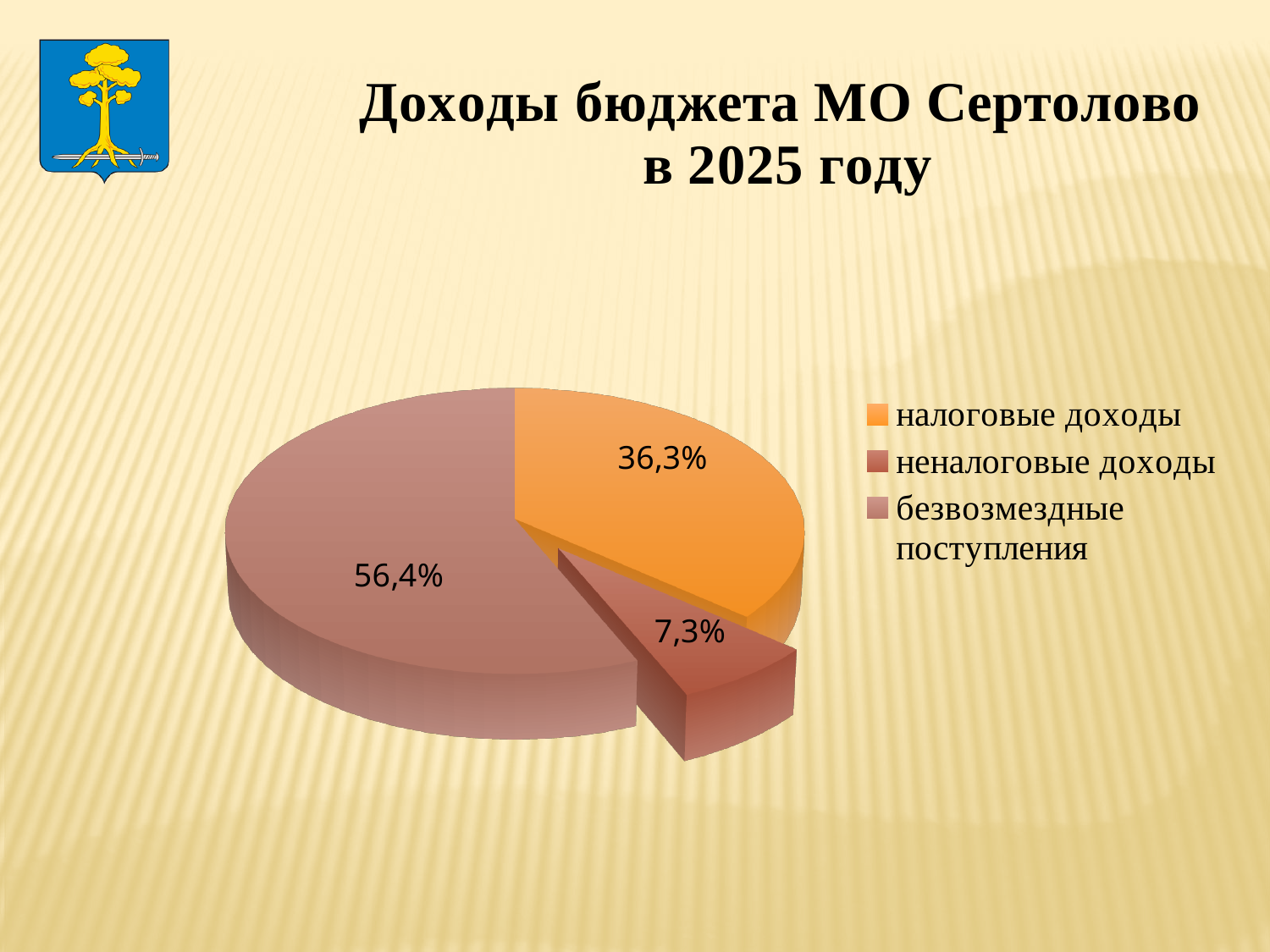
Which is larger: the share of налоговые доходы or the share of неналоговые доходы? налоговые доходы Which category has the smallest share of the pie? неналоговые доходы What is the difference between the shares of налоговые доходы and неналоговые доходы? 29,0% Which category has the largest share of the pie? безвозмездные поступления What share of the pie does безвозмездные поступления represent? 56,4% What is the difference between the shares of безвозмездные поступления and налоговые доходы? 20,1% How many categories does the pie chart show? 3 What kind of chart is shown on the slide? pie chart What share of the pie does неналоговые доходы represent? 7,3% Which colour represents налоговые доходы in the legend? orange What is the title of the slide containing the chart? Доходы бюджета МО Сертолово в 2025 году What share of the pie does налоговые доходы represent? 36,3%